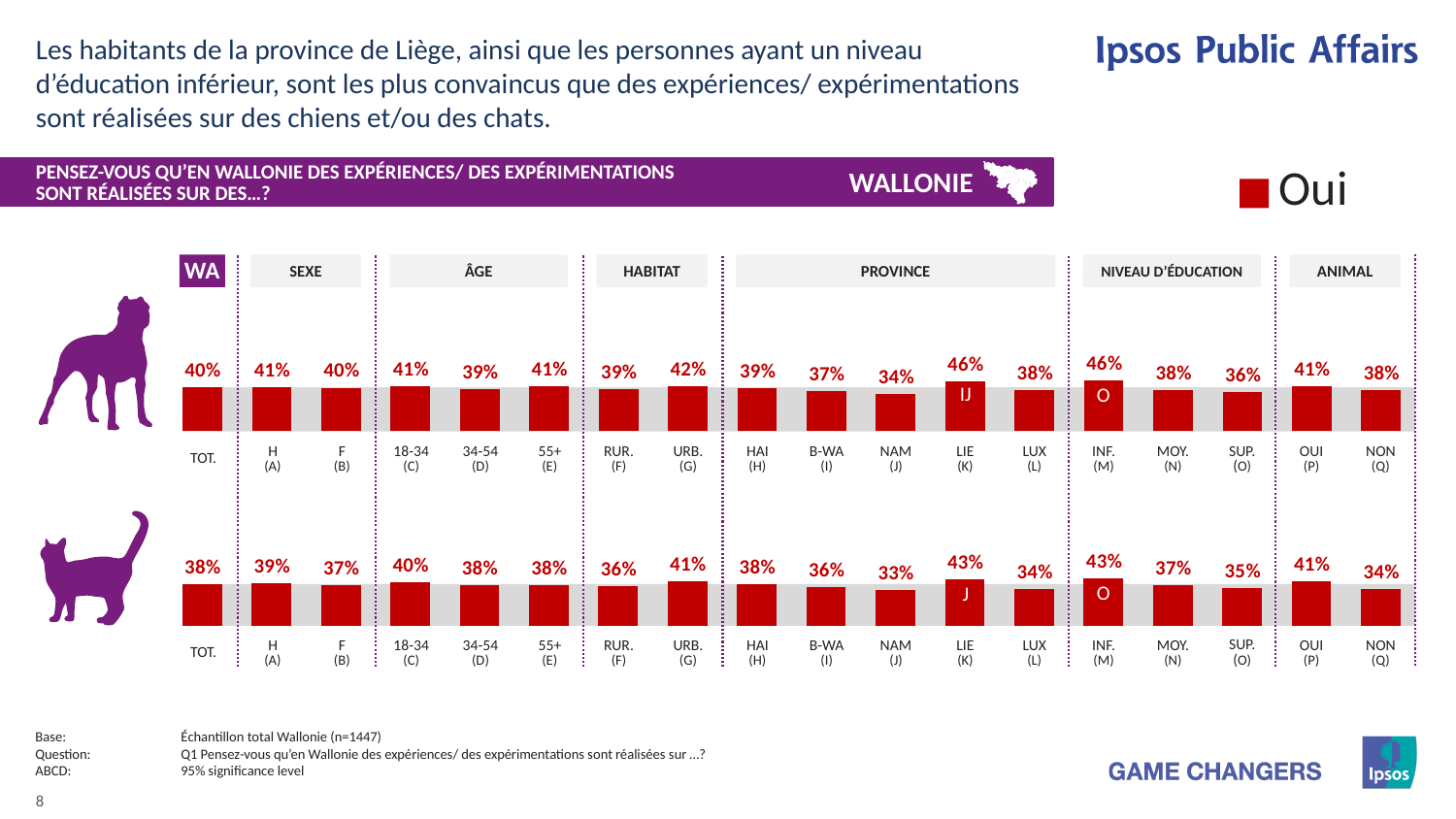
In the top chart (dog), what is the value for URB. (G)? 42% In the bottom chart (cat), what is the difference between the values for INF. (M) and SUP. (O)? 8 percentage points In the bottom chart (cat), what is the value for LIE (K)? 43% In the top chart (dog), which is larger, the value for RUR. (F) or URB. (G)? URB. (G) In the top chart (dog), what is the value for TOT.? 40% What type of chart is used on this slide? Bar chart In the bottom chart (cat), which is larger, the value for OUI (P) or NON (Q)? OUI (P) In the top chart (dog), which category has the lowest value? NAM (J) How many categories are plotted in the top chart (dog)? 18 In the bottom chart (cat), which category has the lowest value? NAM (J) In the top chart (dog), what is the difference between the values for LIE (K) and NAM (J)? 12 percentage points In the bottom chart (cat), what is the value for NON (Q)? 34%